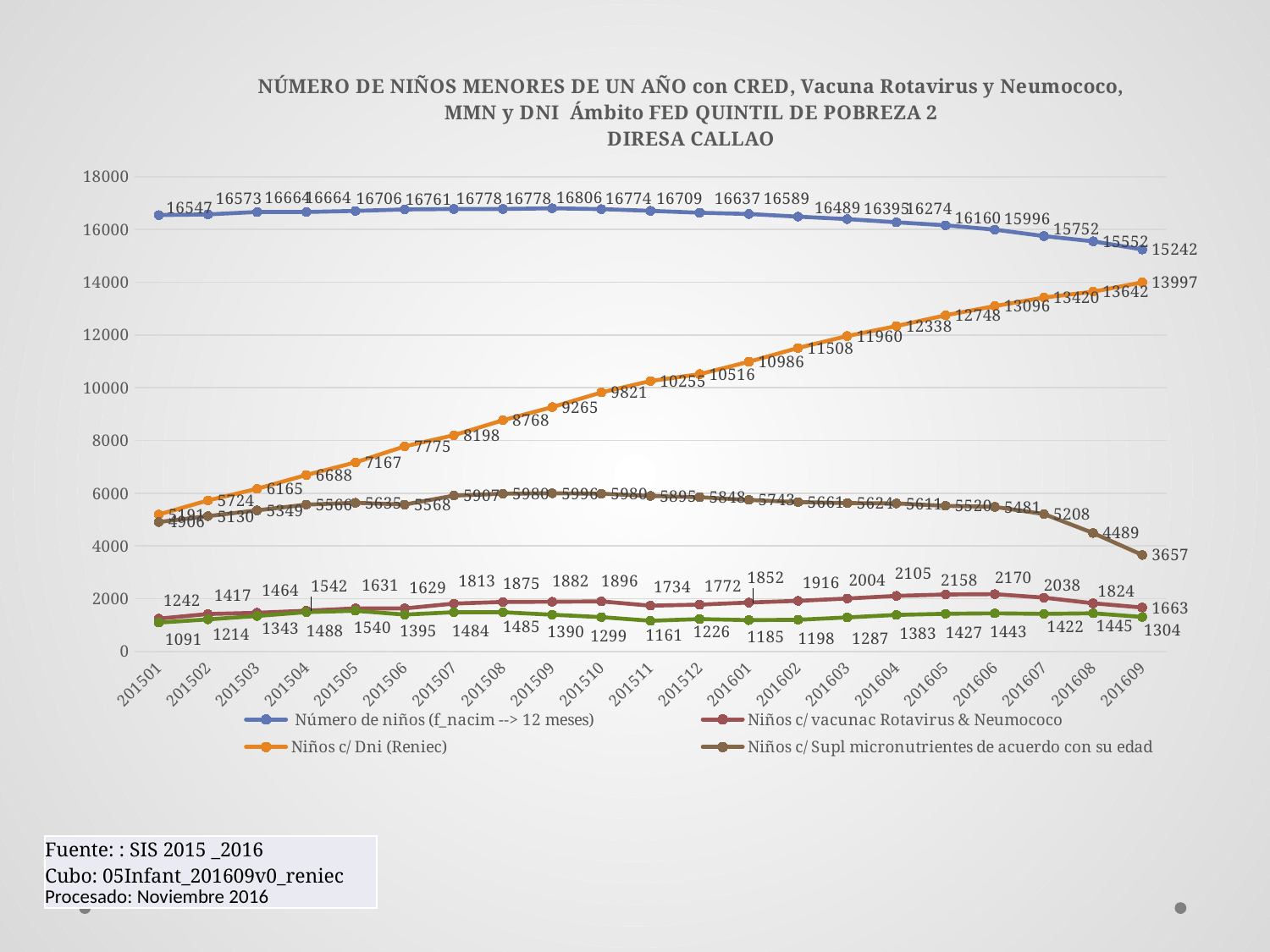
Is the value of Número de niños (f_nacim --> 12 meses) at 201609 greater or less than 16000? less At 201609, which is larger: Niños c/ Supl micronutrientes de acuerdo con su edad or Niños c/ vacunac Rotavirus & Neumococo? Niños c/ Supl micronutrientes de acuerdo con su edad What is the value of Niños c/ Supl micronutrientes de acuerdo con su edad at 201609? 3657 In which period does Niños c/ vacunac Rotavirus & Neumococo reach its highest value? 201606 How many periods are shown on the x axis? 21 What is the value of Número de niños (f_nacim --> 12 meses) at 201501? 16547 How many series does the legend list? 4 In which period is Niños c/ Dni (Reniec) lowest? 201501 What kind of chart is shown on the slide? line chart By how much did Niños c/ Dni (Reniec) increase from 201501 to 201609? 8806 In which period does Número de niños (f_nacim --> 12 meses) reach its highest value? 201509 What is the value of Niños c/ Dni (Reniec) at 201609? 13997